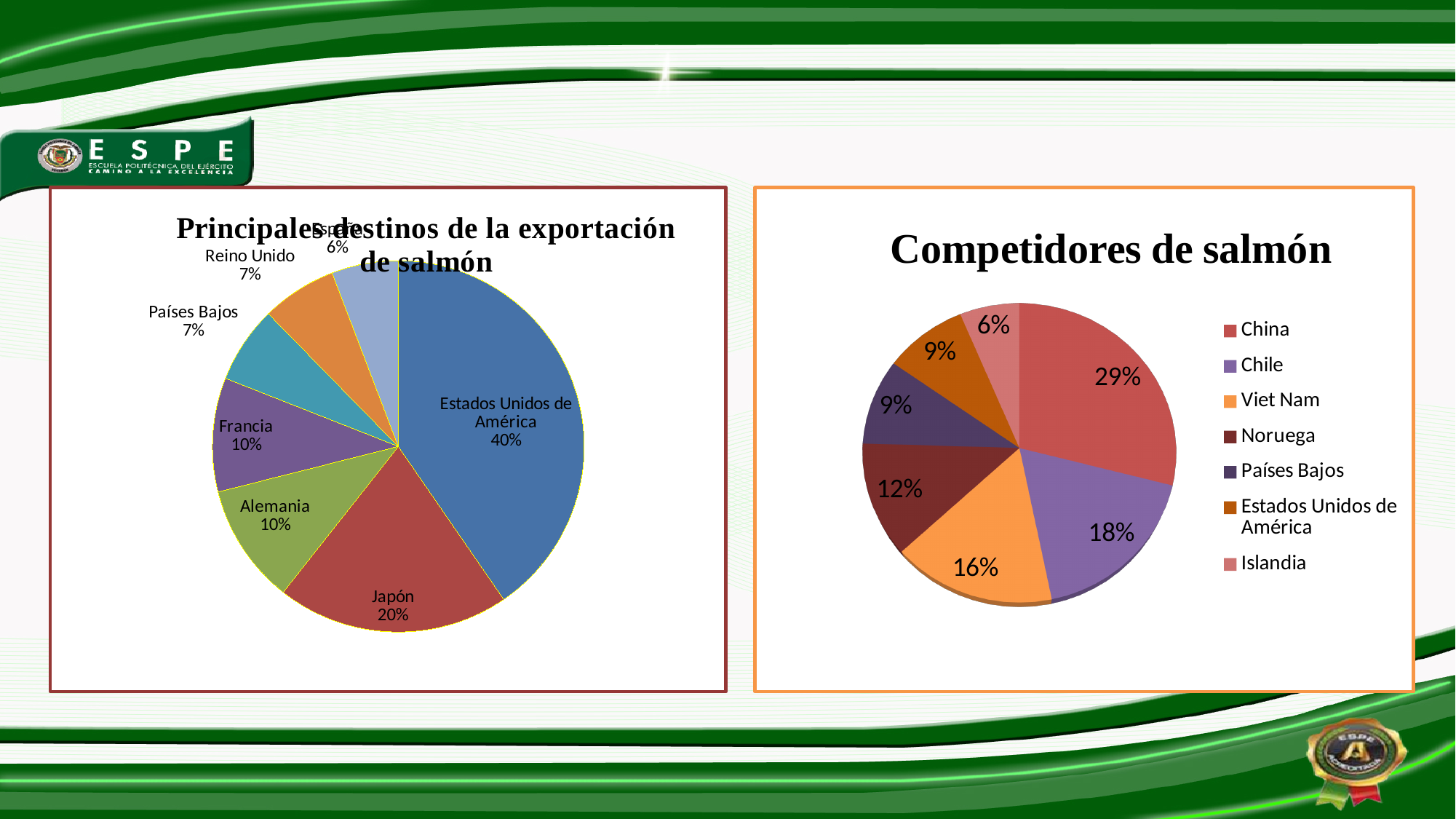
In the chart 'Competidores de salmón', what share does Viet Nam have? 16% In the chart 'Principales destinos de la exportación de salmón', what share does Japón have? 20% In the chart 'Principales destinos de la exportación de salmón', how many destinations are shown? 7 In the chart 'Competidores de salmón', which competitor has the smallest share? Islandia In the chart 'Principales destinos de la exportación de salmón', what is the difference between the shares of Estados Unidos de América and Japón? 20 percentage points In the chart 'Competidores de salmón', which is larger, the share of Chile or the share of Noruega? Chile In the chart 'Competidores de salmón', what is the difference between the shares of China and Chile? 11 percentage points In the chart 'Competidores de salmón', how many entries does the legend list? 7 In the chart 'Principales destinos de la exportación de salmón', what share does Estados Unidos de América have? 40% What kind of chart is 'Principales destinos de la exportación de salmón'? Pie chart In the chart 'Competidores de salmón', what share does China have? 29% In the chart 'Principales destinos de la exportación de salmón', which destination has the largest share? Estados Unidos de América